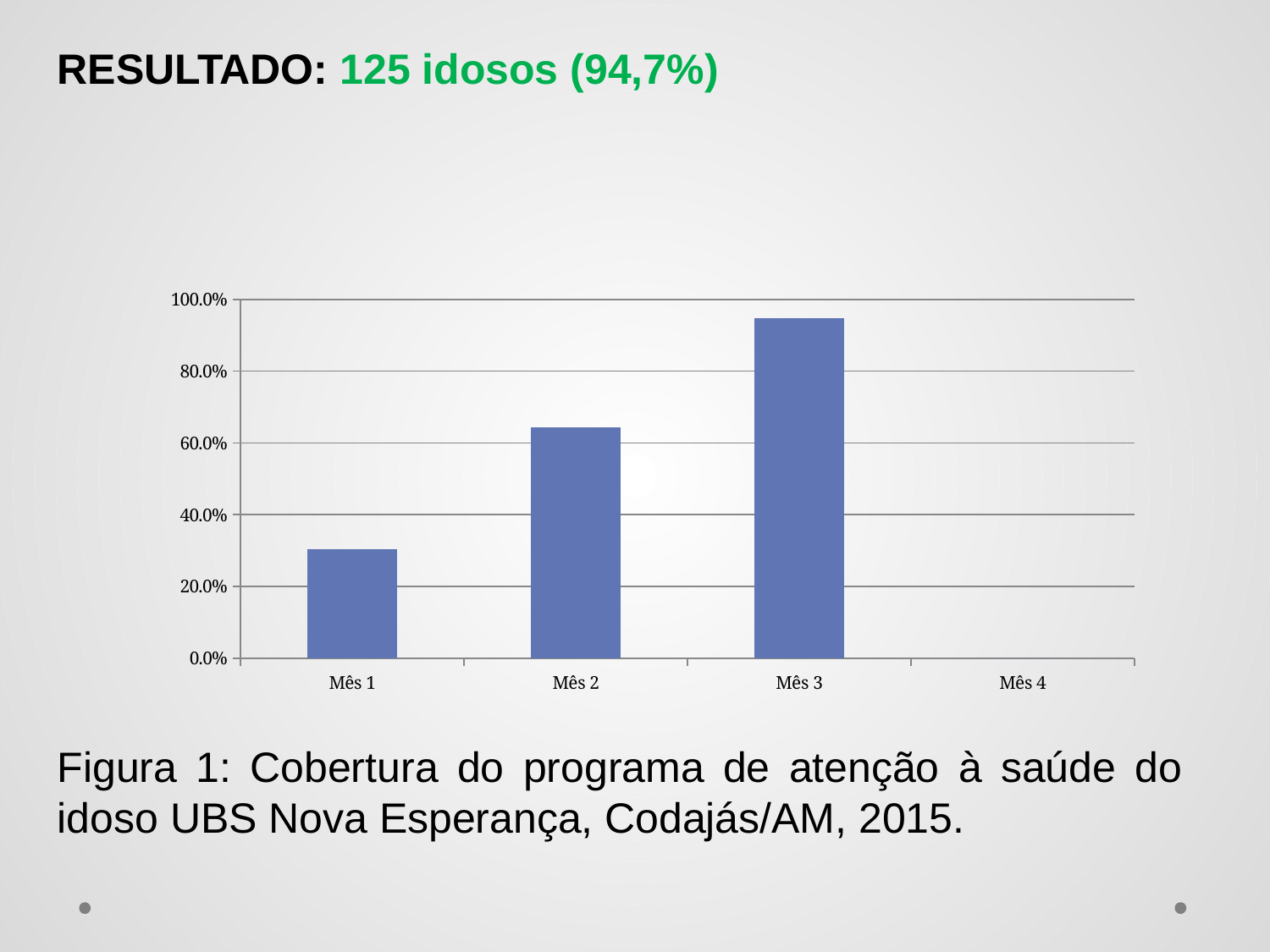
Do the values rise or fall from Mês 1 to Mês 3? rise Which month has the highest bar in the chart? Mês 3 What kind of chart is shown on the slide? Bar chart Is the value for Mês 3 greater or less than 80.0%? greater Which is larger, the value for Mês 2 or the value for Mês 1? Mês 2 Is the value for Mês 1 greater or less than 20.0%? greater Which month on the x axis has no bar plotted? Mês 4 Is the value for Mês 2 greater or less than 80.0%? less Among the months with a visible bar, which has the lowest value? Mês 1 What colour are the bars in the chart? Blue How many month categories are shown on the x axis of the chart? 4